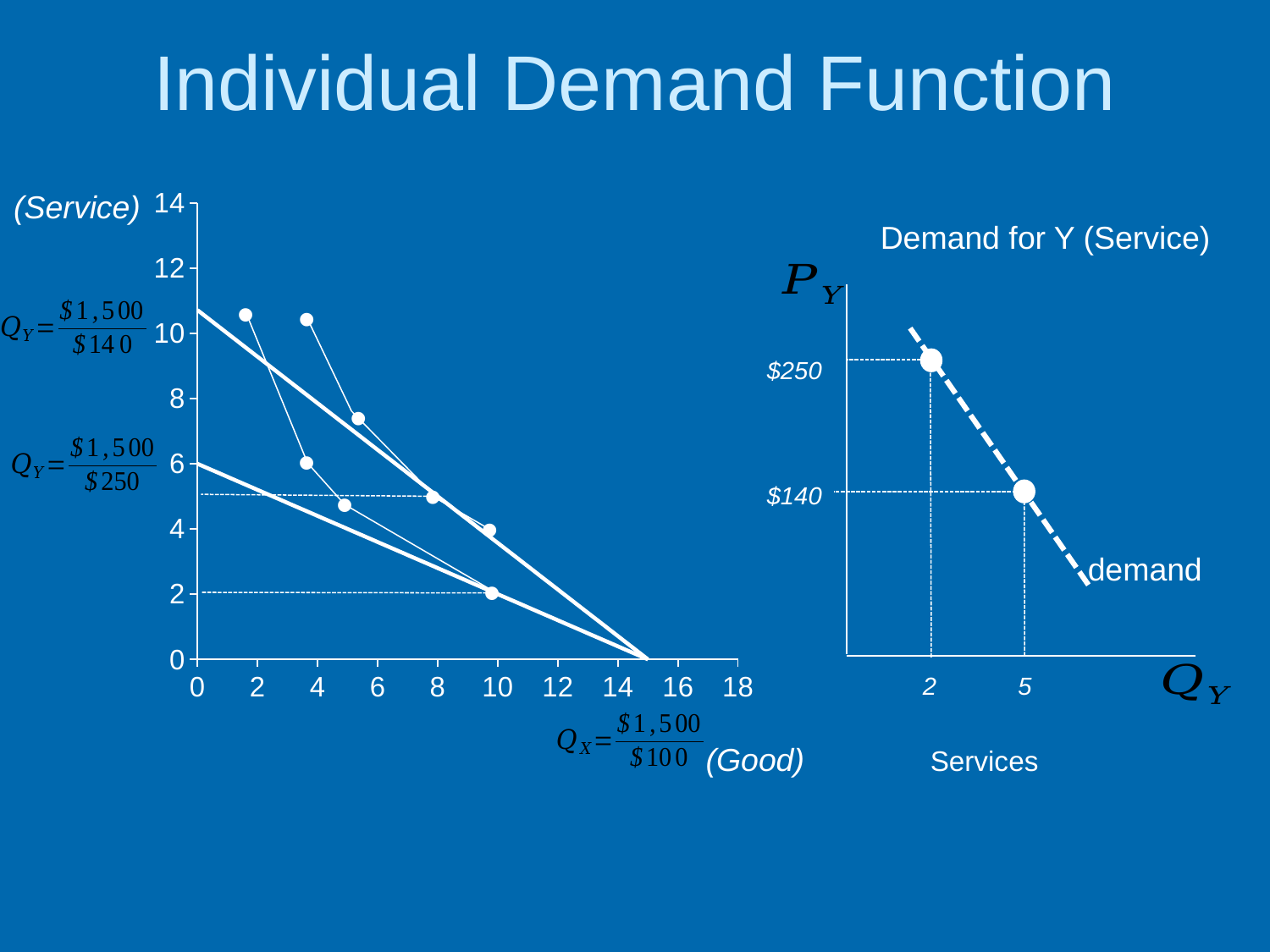
On the Demand for Y (Service) chart, what quantity Q_Y is demanded at a price of $250? 2 On the Demand for Y (Service) chart, what is the price P_Y when the quantity Q_Y is 5? $140 On the Demand for Y (Service) chart, what is the price P_Y when the quantity Q_Y is 2? $250 On the left chart, is the vertical-axis intercept of the upper (steeper) budget line greater or less than 10? greater On the left chart, is the vertical-axis intercept of the lower budget line greater or less than 8? less On the Demand for Y (Service) chart, what is the difference between the two labelled prices, $250 and $140? $110 What is the title of the chart on the right side of the slide? Demand for Y (Service) On the Demand for Y (Service) chart, does the price rise or fall as the quantity Q_Y increases? Fall On the Demand for Y (Service) chart, what quantity Q_Y is demanded at a price of $140? 5 On the Demand for Y (Service) chart, what label is written next to the dashed line? demand On the left chart, is the horizontal-axis intercept where the two budget lines meet greater or less than 14? greater On the Demand for Y (Service) chart, which point has the higher price: the one at quantity 2 or the one at quantity 5? The point at quantity 2 ($250)